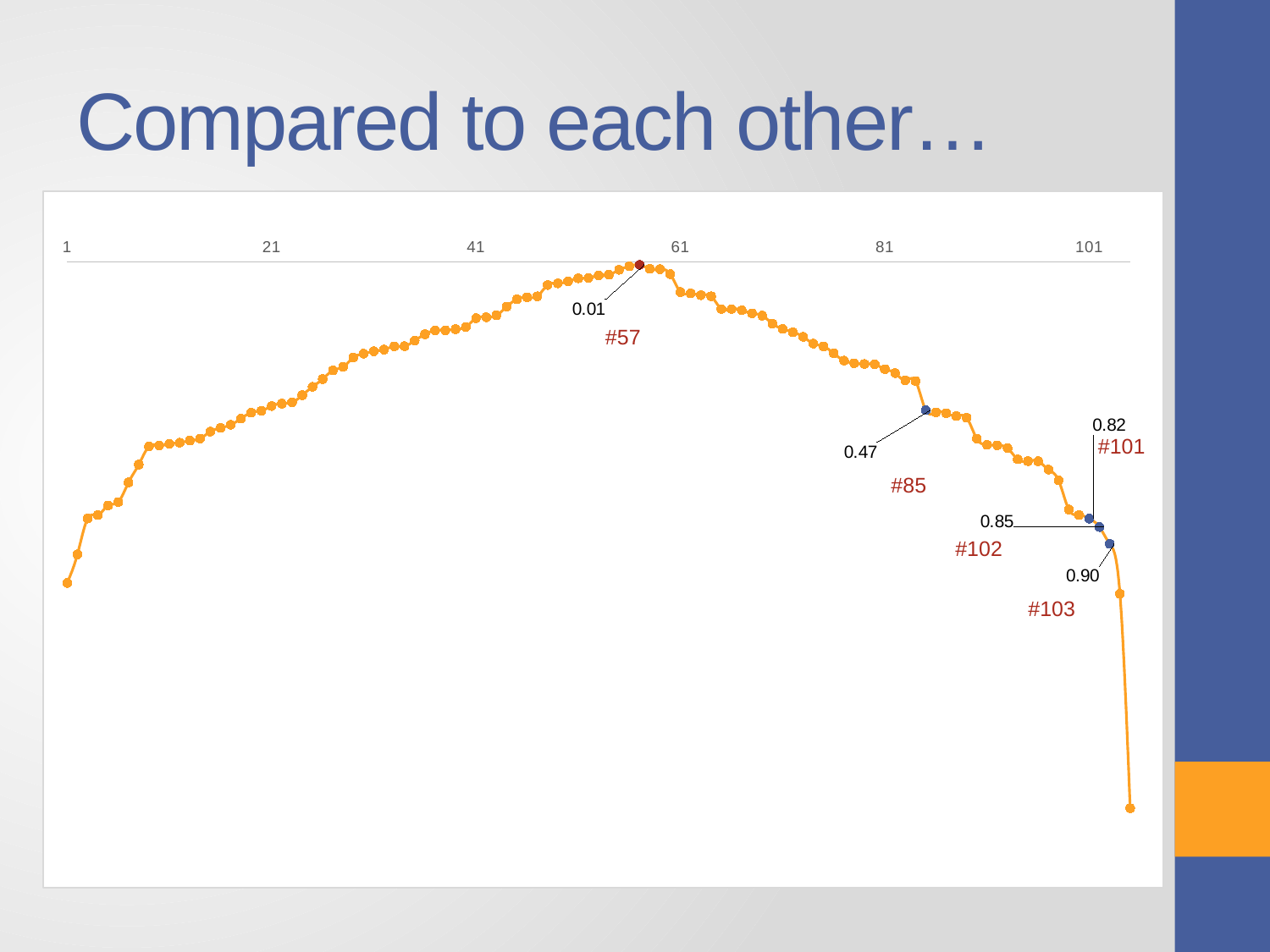
What value is labelled at point #102? 0.85 What value is labelled at point #57? 0.01 What is the difference between the labelled values at #85 and #57? 0.46 Which of the labelled points has the smallest value? #57 What value is labelled at point #85? 0.47 What is the difference between the labelled values at #103 and #101? 0.08 How many points on the chart have a value label? 5 What is the difference between the labelled values at #102 and #101? 0.03 Which labelled point has the larger value, #102 or #85? #102 What value is labelled at point #103? 0.90 What value is labelled at point #101? 0.82 What kind of chart is shown on the slide? Line chart